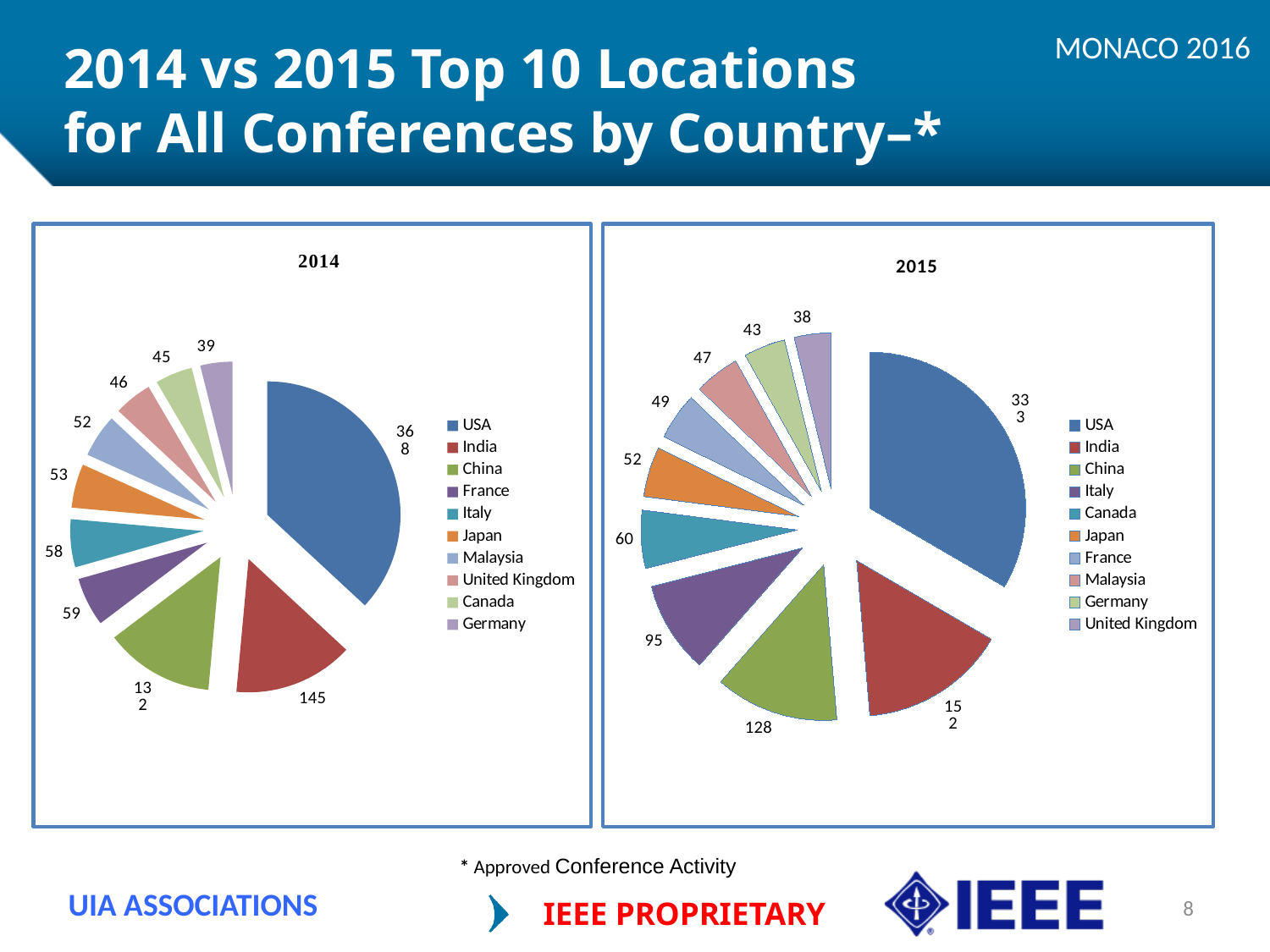
How many countries are listed in the legend of the 2015 pie chart? 10 In the 2014 pie chart, what is the value for Germany? 39 In the 2014 pie chart, what is the value for India? 145 In the 2014 pie chart, which country has the smallest slice? Germany In the 2014 pie chart, which country has the largest slice? USA In the 2015 pie chart, which country has the smallest slice? United Kingdom What type of chart is used for the 2014 data? Pie chart In the 2015 pie chart, what is the value for China? 128 In the 2015 pie chart, what is the value for United Kingdom? 38 In the 2015 pie chart, what is the difference between the values for Italy and Canada? 35 In the 2015 pie chart, what is the value for Italy? 95 In the 2014 pie chart, which is larger, the value for France or the value for Japan? France